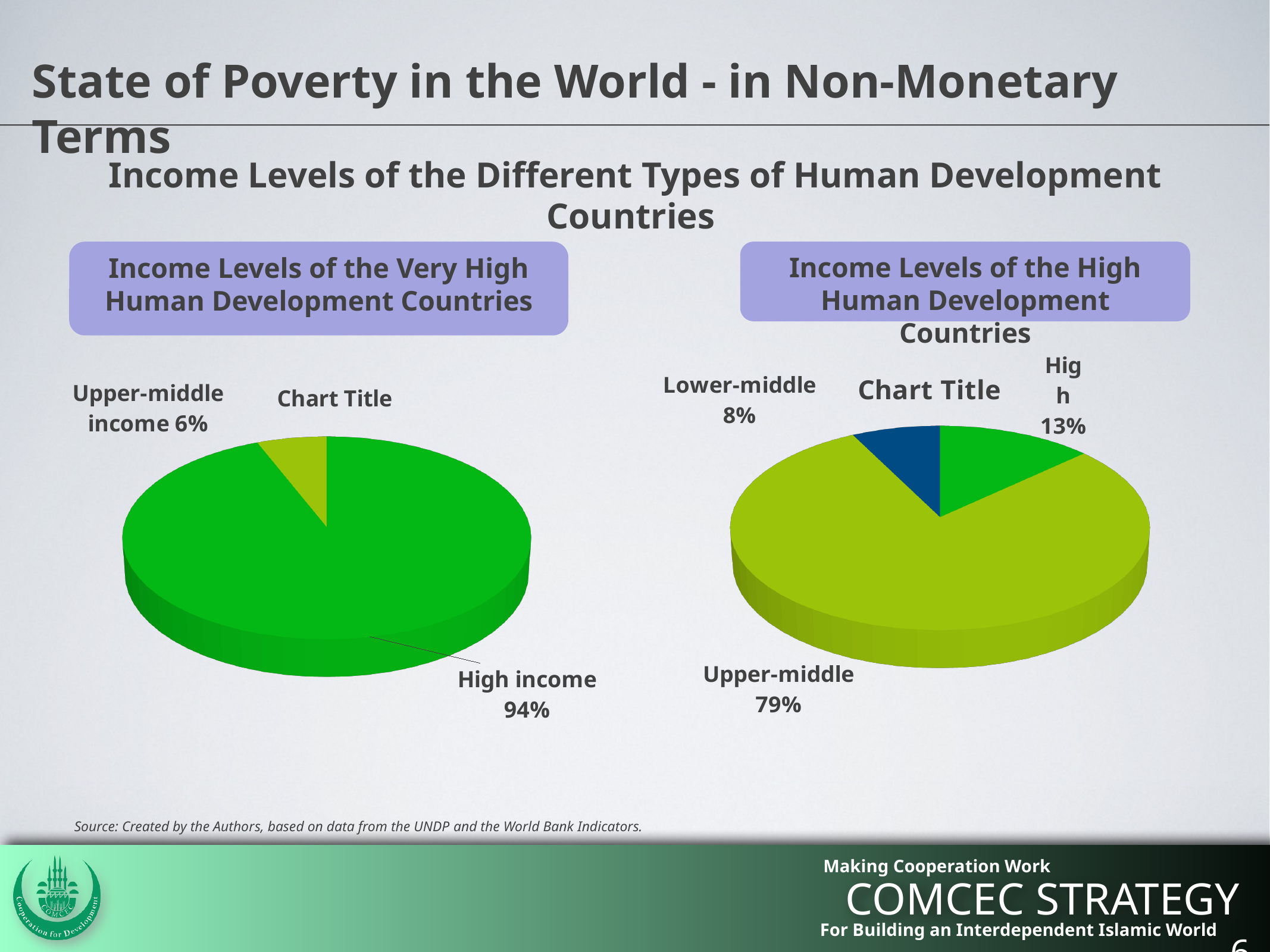
How many slices does the right pie chart (Income Levels of the High Human Development Countries) have? 3 In the left pie chart (Income Levels of the Very High Human Development Countries), what is the difference between the High income and Upper-middle income shares? 88% In the right pie chart (Income Levels of the High Human Development Countries), what is the difference between the Upper-middle and High shares? 66% In the right pie chart (Income Levels of the High Human Development Countries), which category has the smallest slice? Lower-middle In the right pie chart (Income Levels of the High Human Development Countries), what share is Upper-middle? 79% In the right pie chart (Income Levels of the High Human Development Countries), what share is High? 13% In the right pie chart (Income Levels of the High Human Development Countries), what share is Lower-middle? 8% In the left pie chart (Income Levels of the Very High Human Development Countries), what share is Upper-middle income? 6% What type of chart is the left chart (Income Levels of the Very High Human Development Countries)? Pie chart In the right pie chart (Income Levels of the High Human Development Countries), which category has the largest slice? Upper-middle In the left pie chart (Income Levels of the Very High Human Development Countries), what share is High income? 94% In the right pie chart (Income Levels of the High Human Development Countries), which is larger: High or Lower-middle? High